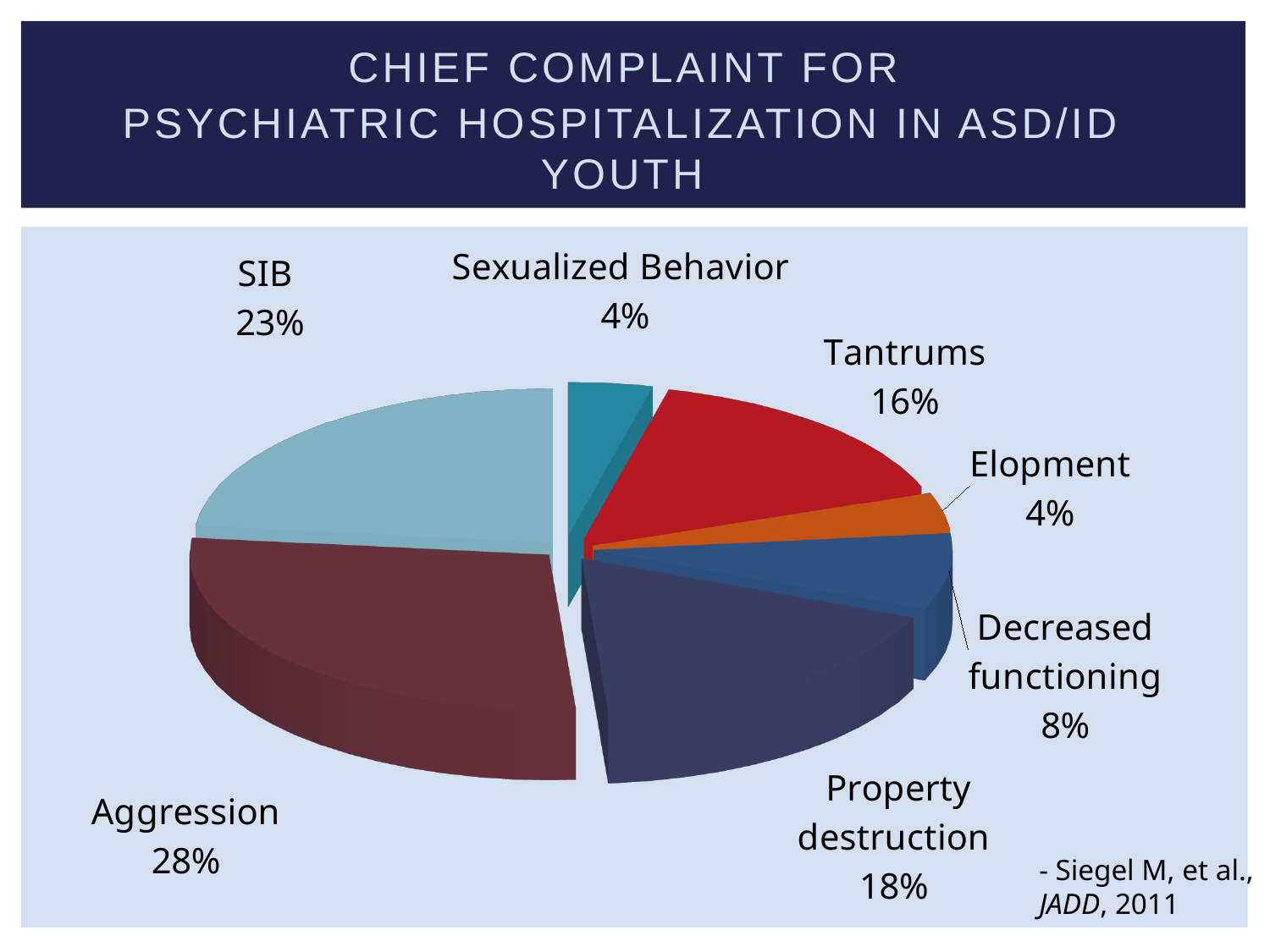
What is the title of the chart on the slide? Chief Complaint for Psychiatric Hospitalization in ASD/ID Youth What is the difference in percentage points between Aggression and SIB? 5 Which is larger, Tantrums or Decreased functioning? Tantrums How many chief complaint categories are shown in the pie chart? 7 What percentage is shown for Property destruction? 18% What percentage is shown for Decreased functioning? 8% What is the difference in percentage points between Property destruction and Tantrums? 2 What type of chart is shown on the slide? Pie chart What percentage is shown for SIB? 23% Which chief complaint has the largest share of the pie? Aggression What share of chief complaints is Aggression? 28% Which two chief complaints share the smallest percentage? Sexualized Behavior and Elopment